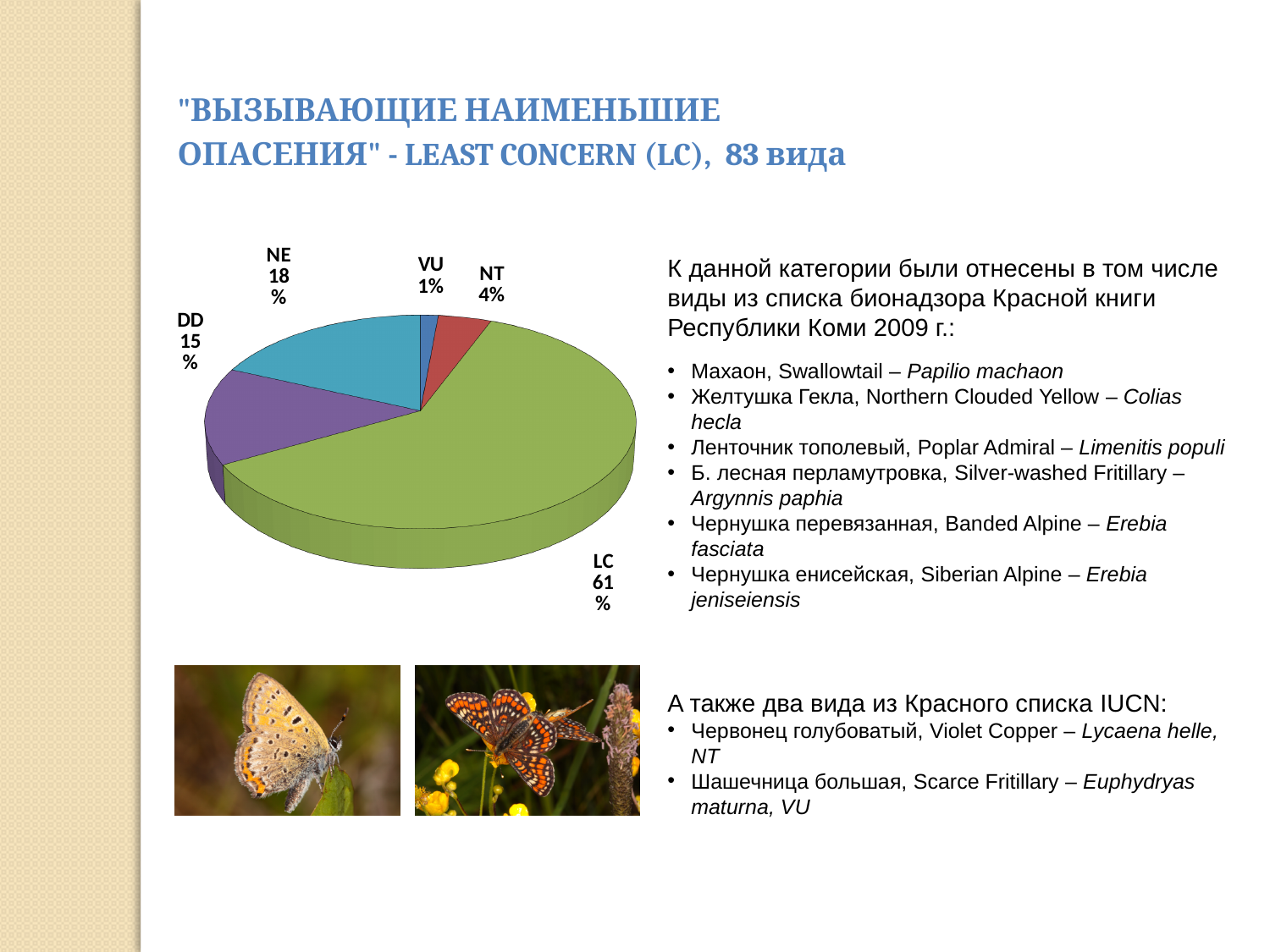
What kind of chart is shown on the slide? pie chart What colour is the LC slice of the pie chart? green What is the difference in percentage points between the LC slice and the NE slice? 43 How many slices does the pie chart have? 5 Which category has the largest slice of the pie? LC Which slice is larger, NE or DD? NE What share of the pie does the VU slice represent? 1% What share of the pie does the LC slice represent? 61% What share of the pie does the NT slice represent? 4% Which category has the smallest slice of the pie? VU